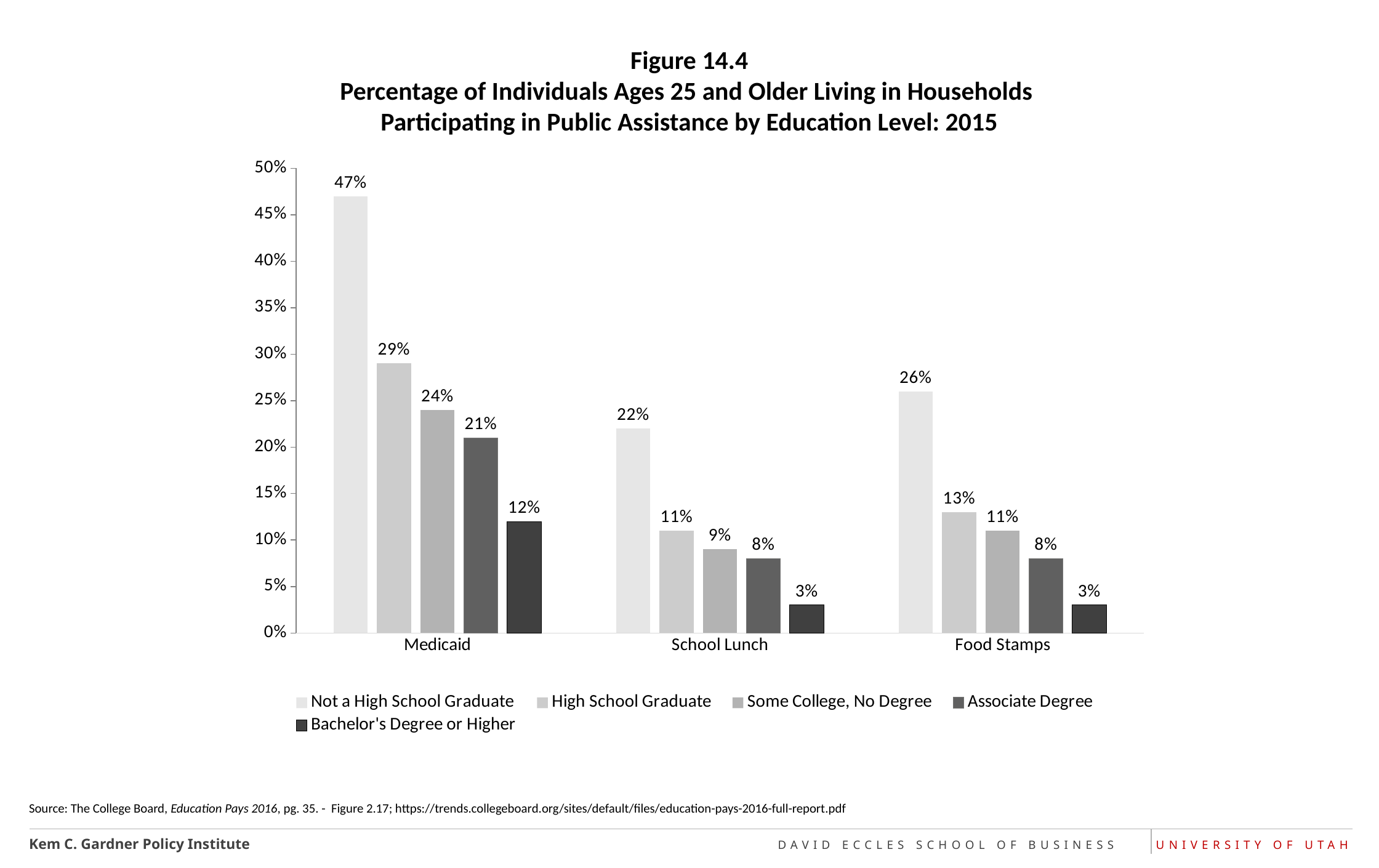
Which education level has the highest value in the Food Stamps category? Not a High School Graduate What is the value for Not a High School Graduate in the Medicaid category? 47% Which is larger: the Associate Degree value for Medicaid or the Associate Degree value for Food Stamps? Medicaid Which education level has the lowest value in the Medicaid category? Bachelor's Degree or Higher How many series does the legend list? 5 What year does the chart title say the data is for? 2015 How many categories are shown on the x axis? 3 Within the School Lunch category, do the values rise or fall as education level increases from Not a High School Graduate to Bachelor's Degree or Higher? Fall What kind of chart is shown on the slide? Bar chart What is the value for High School Graduate in the Food Stamps category? 13% What is the value for Bachelor's Degree or Higher in the School Lunch category? 3% What is the difference between the Not a High School Graduate and High School Graduate values in the Medicaid category? 18%